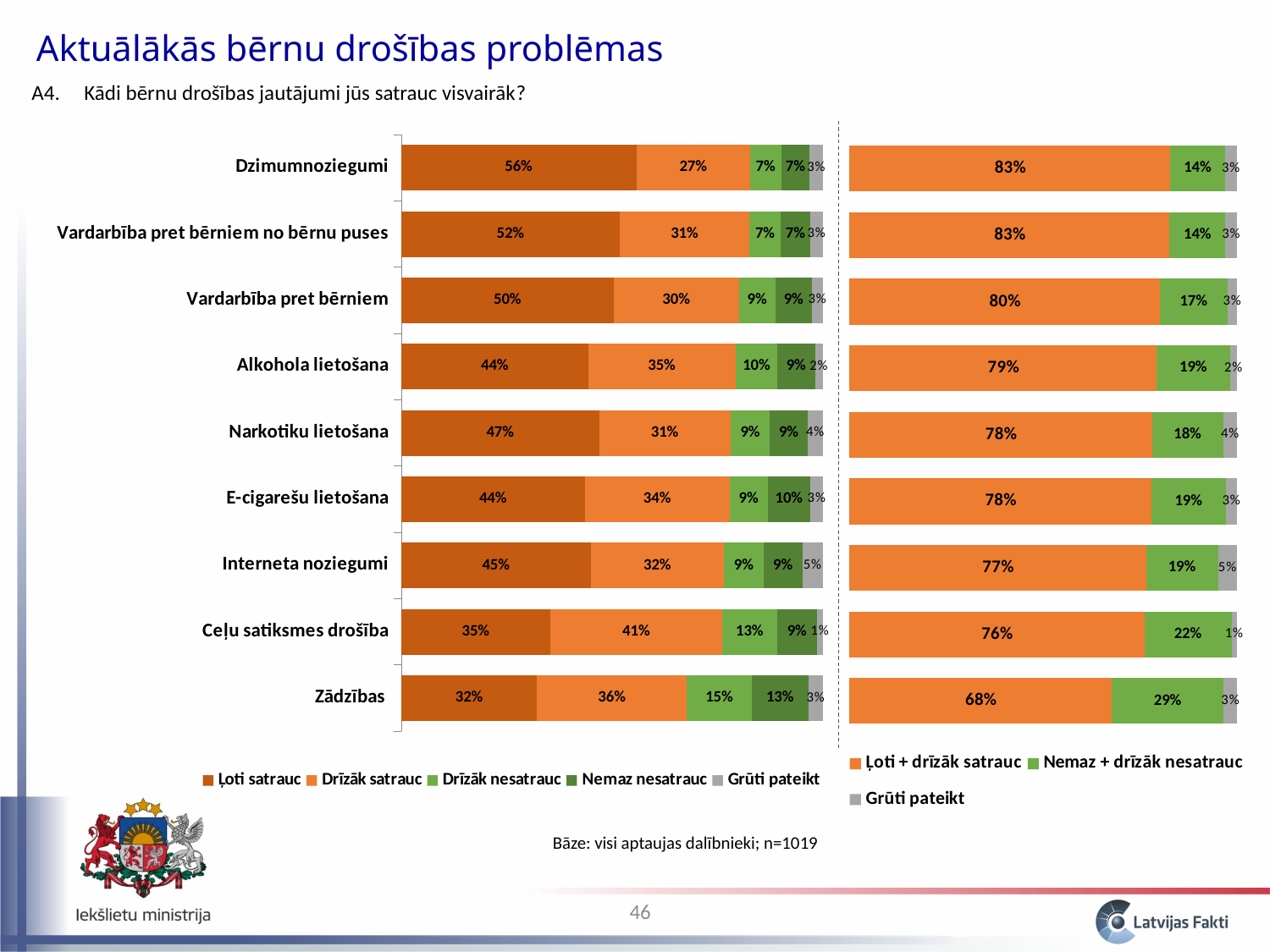
In the left chart, what is the 'Drīzāk satrauc' value for Ceļu satiksmes drošība? 41% In the left chart, which is larger: the 'Ļoti satrauc' value for Alkohola lietošana or for Narkotiku lietošana? Narkotiku lietošana In the right chart, which category has the lowest 'Ļoti + drīzāk satrauc' value? Zādzības How many series does the legend of the left chart list? 5 In the right chart, what is the difference between the 'Ļoti + drīzāk satrauc' values for Dzimumnoziegumi and Zādzības? 15% In the right chart, what is the 'Nemaz + drīzāk nesatrauc' value for Ceļu satiksmes drošība? 22% In the left chart, which category has the highest 'Ļoti satrauc' value? Dzimumnoziegumi What type of chart is the left chart? Stacked bar chart How many series does the legend of the right chart list? 3 In the left chart, what is the 'Ļoti satrauc' value for Dzimumnoziegumi? 56% In the right chart, what is the 'Ļoti + drīzāk satrauc' value for Zādzības? 68% How many categories are shown in the left chart? 9